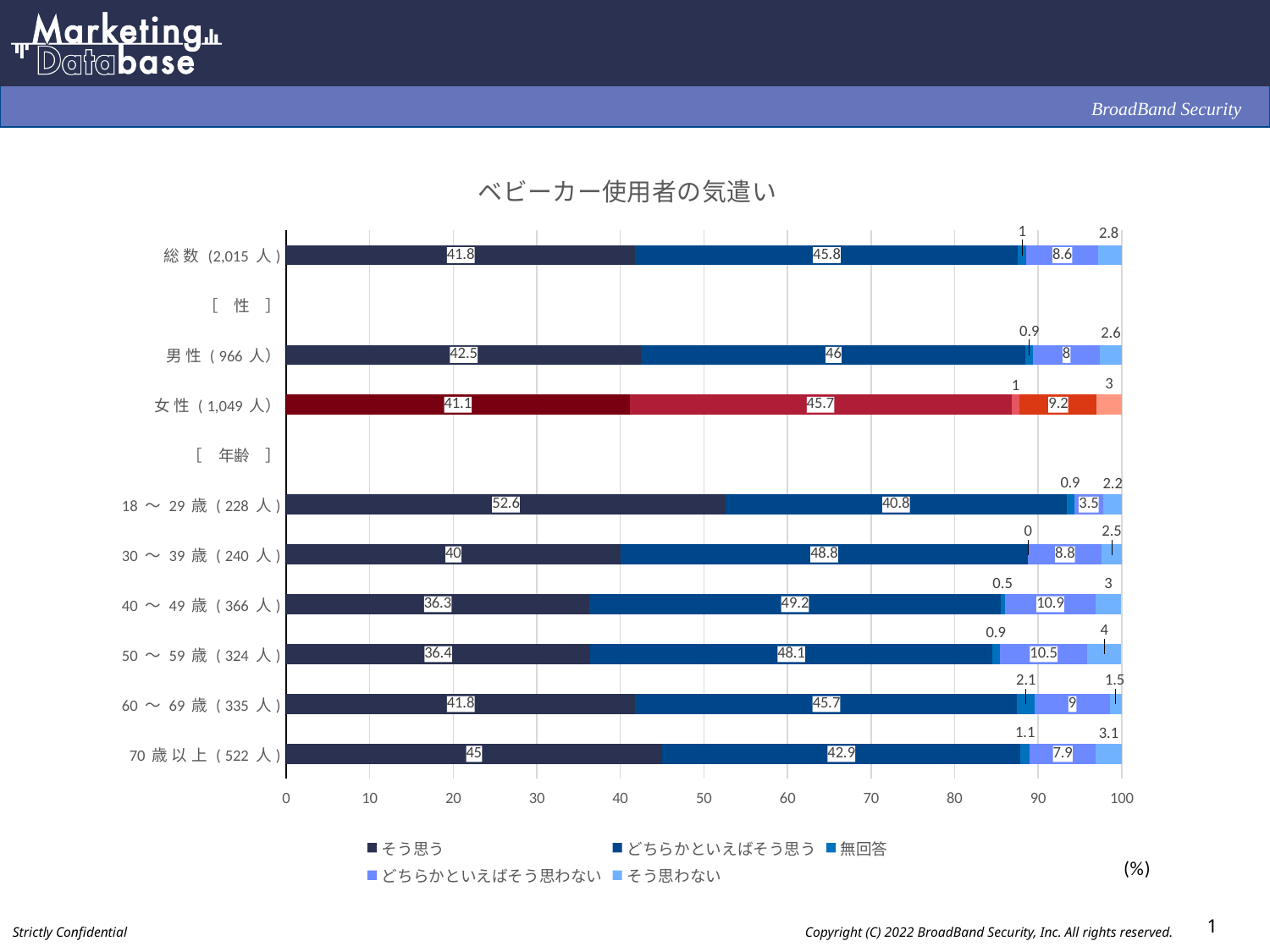
What kind of chart is shown on the slide? Stacked bar chart What is the value of そう思わない for 50 〜 59 歳 (324 人)? 4 What is the value of そう思う for 総数 (2,015 人)? 41.8 Which category has the lowest value for どちらかといえばそう思わない? 18 〜 29 歳 (228 人) How many categories (bars) are plotted in the chart? 9 Which category has the highest value for そう思う? 18 〜 29 歳 (228 人) How many series does the legend list? 5 What is the value of どちらかといえばそう思う for 女性 (1,049 人)? 45.7 What is the difference between the そう思う values for 男性 (966 人) and 女性 (1,049 人)? 1.4 What is the title of the chart? ベビーカー使用者の気遣い What is the value of どちらかといえばそう思わない for 40 〜 49 歳 (366 人)? 10.9 Which is larger: the どちらかといえばそう思う value for 30 〜 39 歳 (240 人) or for 70 歳 以上 (522 人)? 30 〜 39 歳 (240 人)